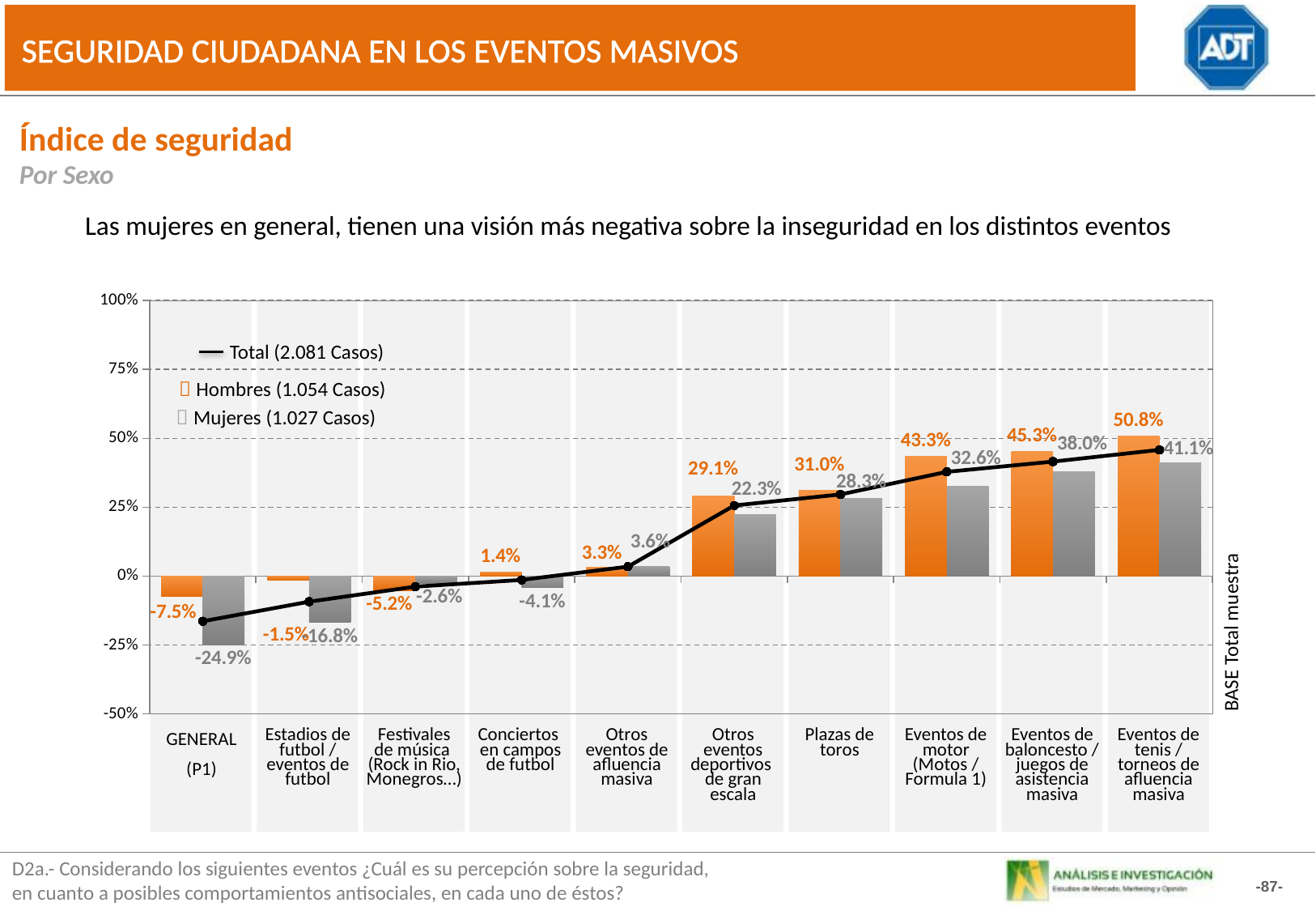
How many series does the legend list? 3 Which category has the highest Hombres value? Eventos de tenis / torneos de afluencia masiva Which category has the lowest Mujeres value? GENERAL (P1) What is the Mujeres value for GENERAL (P1)? -24.9% How many categories are shown on the x axis? 10 What is the Mujeres value for Plazas de toros? 28.3% For Otros eventos de afluencia masiva, which is larger: the Hombres value or the Mujeres value? Mujeres Do the Hombres values rise or fall from left to right along the x axis? Rise What kind of chart is shown? Combined bar and line chart What is the Hombres value for Eventos de tenis / torneos de afluencia masiva? 50.8% What is the difference between the Hombres and Mujeres values for Eventos de motor (Motos / Formula 1)? 10.7 percentage points Is the Total line value for Eventos de tenis / torneos de afluencia masiva greater or less than 25%? greater